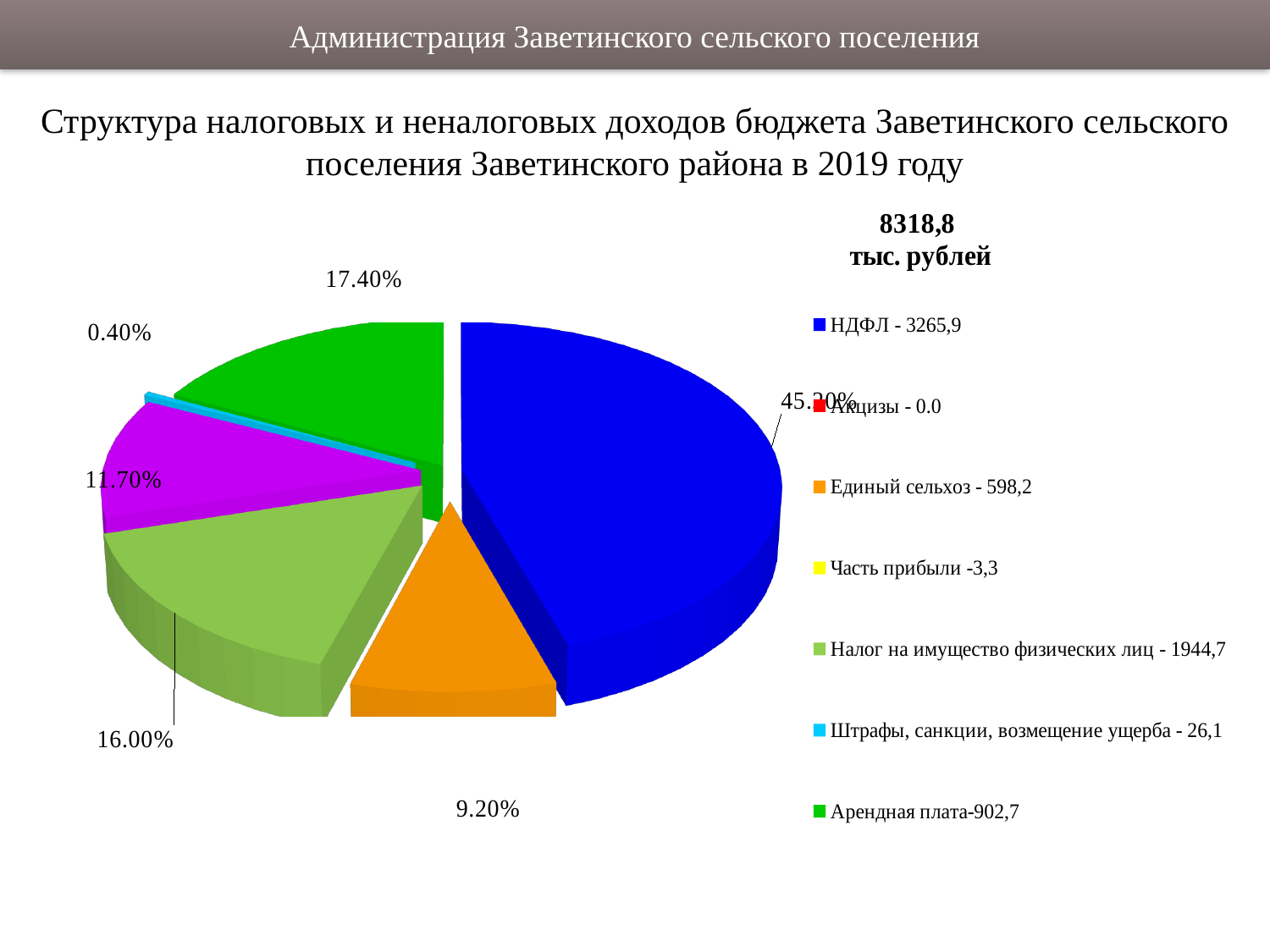
What total amount in тыс. рублей is shown above the legend? 8318,8 What value does the legend give for Налог на имущество физических лиц? 1944,7 Which category has the largest value in the pie chart? НДФЛ What kind of chart is shown on the slide? pie chart What value does the legend give for НДФЛ? 3265,9 Which is larger: Единый сельхоз or Арендная плата? Арендная плата What is the difference between the values for НДФЛ and Налог на имущество физических лиц? 1321,2 What value does the legend give for Арендная плата? 902,7 What share of the pie is labelled for the green Арендная плата slice? 17.40% What value does the legend give for Штрафы, санкции, возмещение ущерба? 26,1 How many entries does the legend list? 7 Which category has the smallest value according to the legend? Акцизы